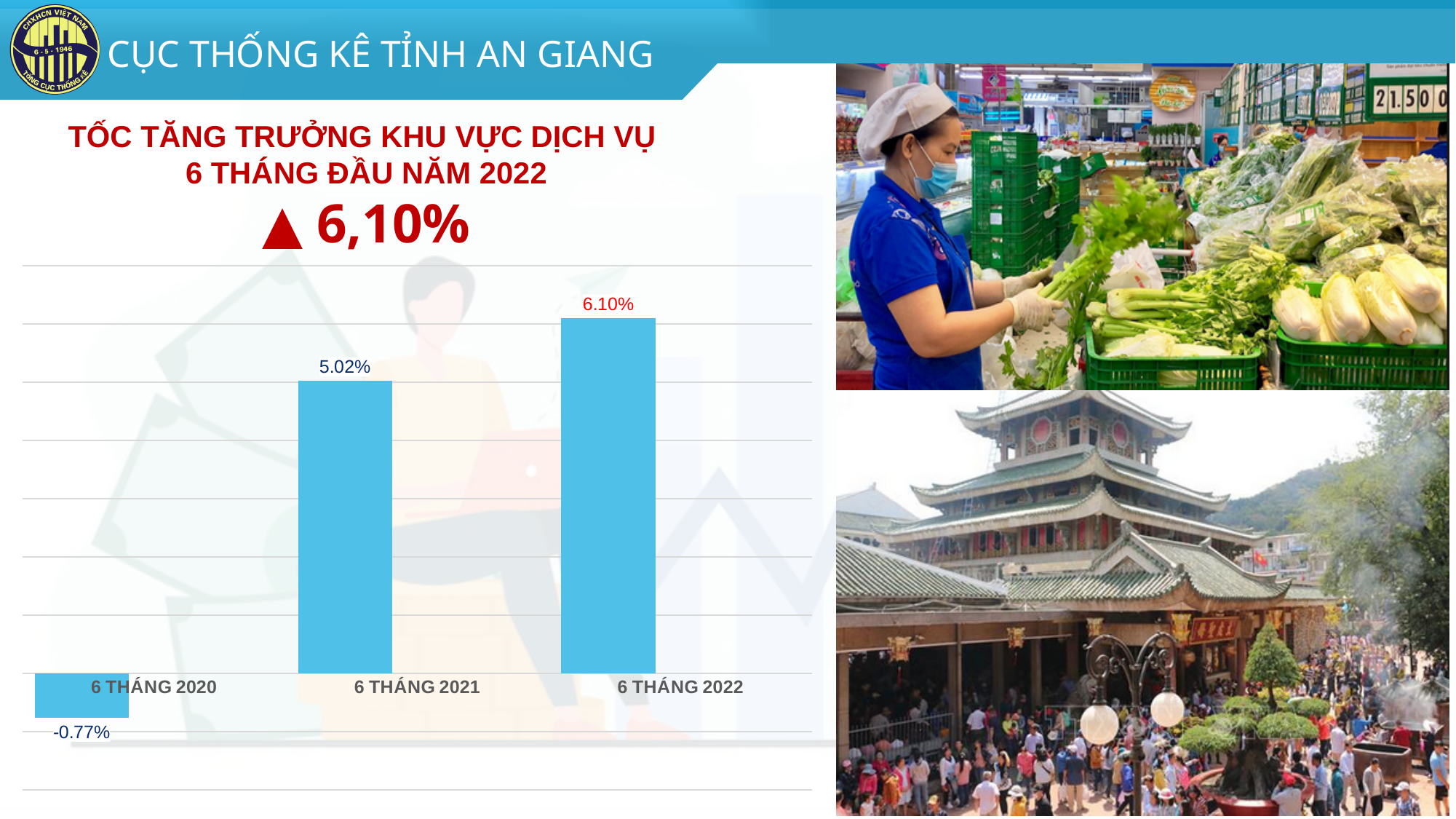
How many categories are shown on the chart? 3 Which is larger, the value for 6 THÁNG 2021 or 6 THÁNG 2022? 6 THÁNG 2022 What is the difference between the values for 6 THÁNG 2021 and 6 THÁNG 2020? 5.79 percentage points What is the value for 6 THÁNG 2022? 6.10% What is the value for 6 THÁNG 2021? 5.02% Do the values rise or fall from 6 THÁNG 2020 to 6 THÁNG 2022? Rise What kind of chart is shown on the slide? Bar chart Which category has the highest value? 6 THÁNG 2022 What is the value for 6 THÁNG 2020? -0.77% Which category has the lowest value? 6 THÁNG 2020 What is the title of the chart? TỐC TĂNG TRƯỞNG KHU VỰC DỊCH VỤ 6 THÁNG ĐẦU NĂM 2022 What is the difference between the values for 6 THÁNG 2022 and 6 THÁNG 2021? 1.08 percentage points